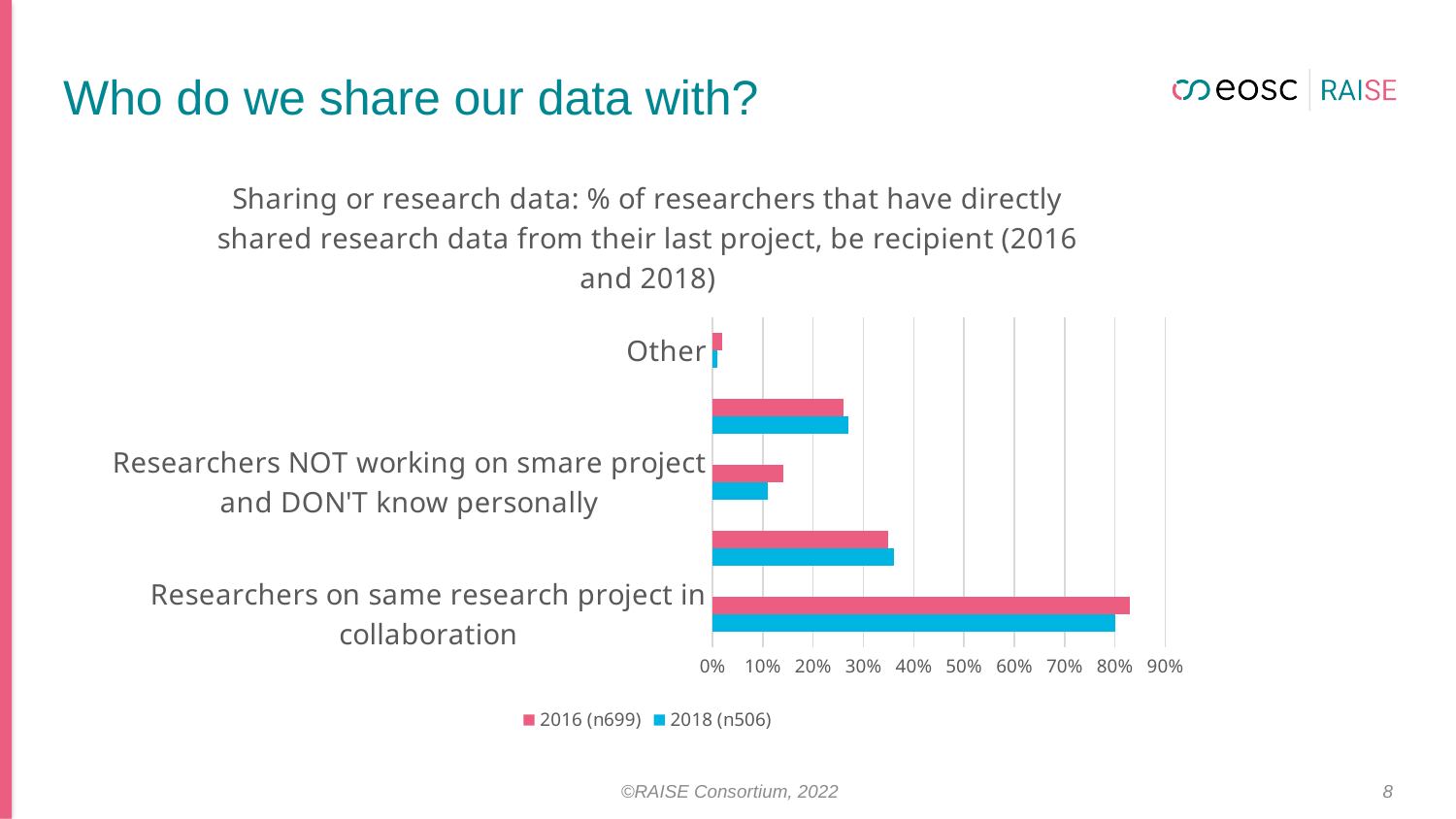
What is the highest percentage tick shown on the chart's horizontal axis? 90% What are the two series named in the chart legend? 2016 (n699) and 2018 (n506) Is the 2016 (n699) value for Researchers on same research project in collaboration greater or less than 70%? greater Is the 2016 (n699) value for Researchers NOT working on same project and DON'T know personally greater or less than 20%? less Which category has the highest value for the 2016 (n699) series? Researchers on same research project in collaboration How many series does the chart legend list? 2 For Researchers on same research project in collaboration, which series has the larger value, 2016 (n699) or 2018 (n506)? 2016 (n699) Is the 2018 (n506) value for Other greater or less than 10%? less Which category has the lowest value for the 2018 (n506) series? Other What kind of chart is shown on the slide? bar chart For Researchers NOT working on same project and DON'T know personally, which series has the larger value, 2016 (n699) or 2018 (n506)? 2016 (n699)